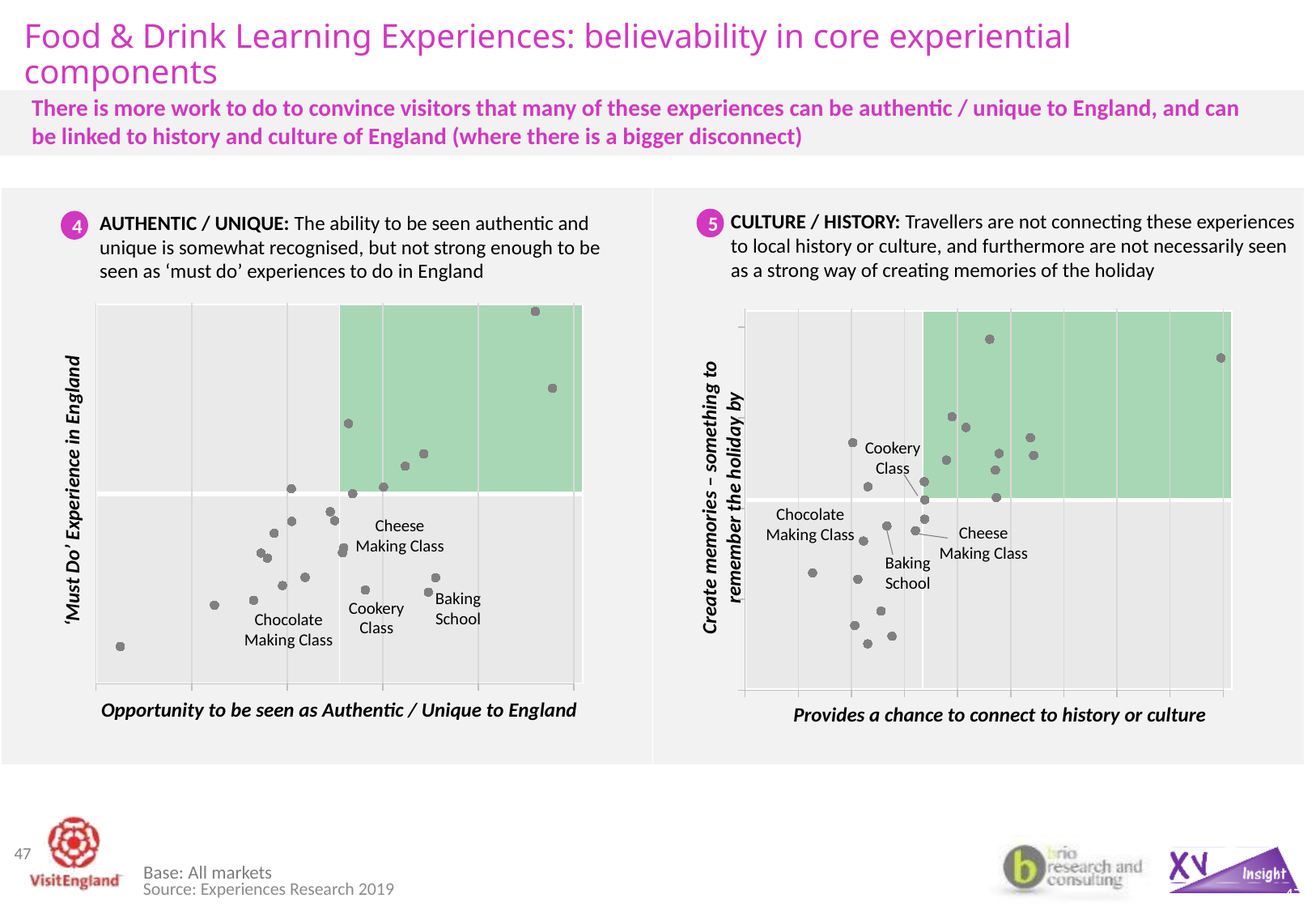
On the right chart, which of the four labelled points is highest on the y axis? Cookery Class On the left chart, which labelled point is higher on the y axis: Cheese Making Class or Chocolate Making Class? Cheese Making Class On the right chart, which labelled point is further to the right on the x axis: Cookery Class or Chocolate Making Class? Cookery Class What kind of chart is the right chart, 'Provides a chance to connect to history or culture'? Scatter chart On the left chart, which labelled point is further to the right on the x axis: Chocolate Making Class or Baking School? Baking School On the left chart, what is the title of the x axis? Opportunity to be seen as Authentic / Unique to England On the left chart, how many data points are labelled with a name? 4 On the right chart, how many data points are labelled with a name? 4 On the right chart, what is the title of the y axis? Create memories – something to remember the holiday by What kind of chart is the left chart, 'Opportunity to be seen as Authentic / Unique to England'? Scatter chart How many charts are shown on the slide? 2